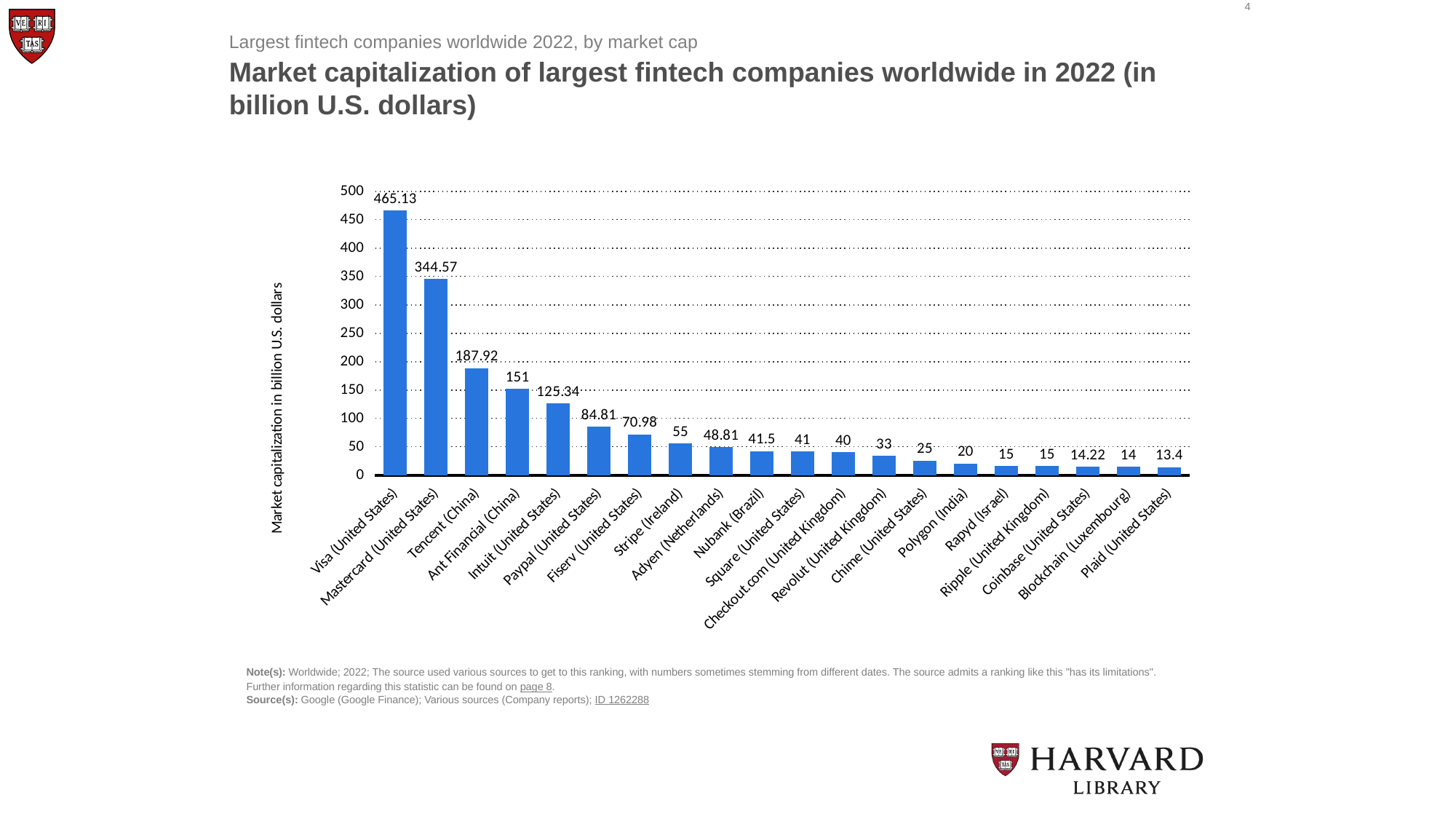
What is the market capitalization of Coinbase (United States)? 14.22 What kind of chart is shown on the slide? Bar chart What is the difference in market capitalization between Visa (United States) and Mastercard (United States)? 120.56 Which company has the lowest market capitalization? Plaid (United States) What is the market capitalization of Stripe (Ireland)? 55 Which company has the highest market capitalization? Visa (United States) Is the value for Ant Financial (China) greater or less than 100? greater What is the market capitalization of Visa (United States)? 465.13 How many companies are shown in the chart? 20 Which has a larger market capitalization, Intuit (United States) or Paypal (United States)? Intuit (United States) Do the values rise or fall from left to right along the x axis? Fall What is the market capitalization of Tencent (China)? 187.92